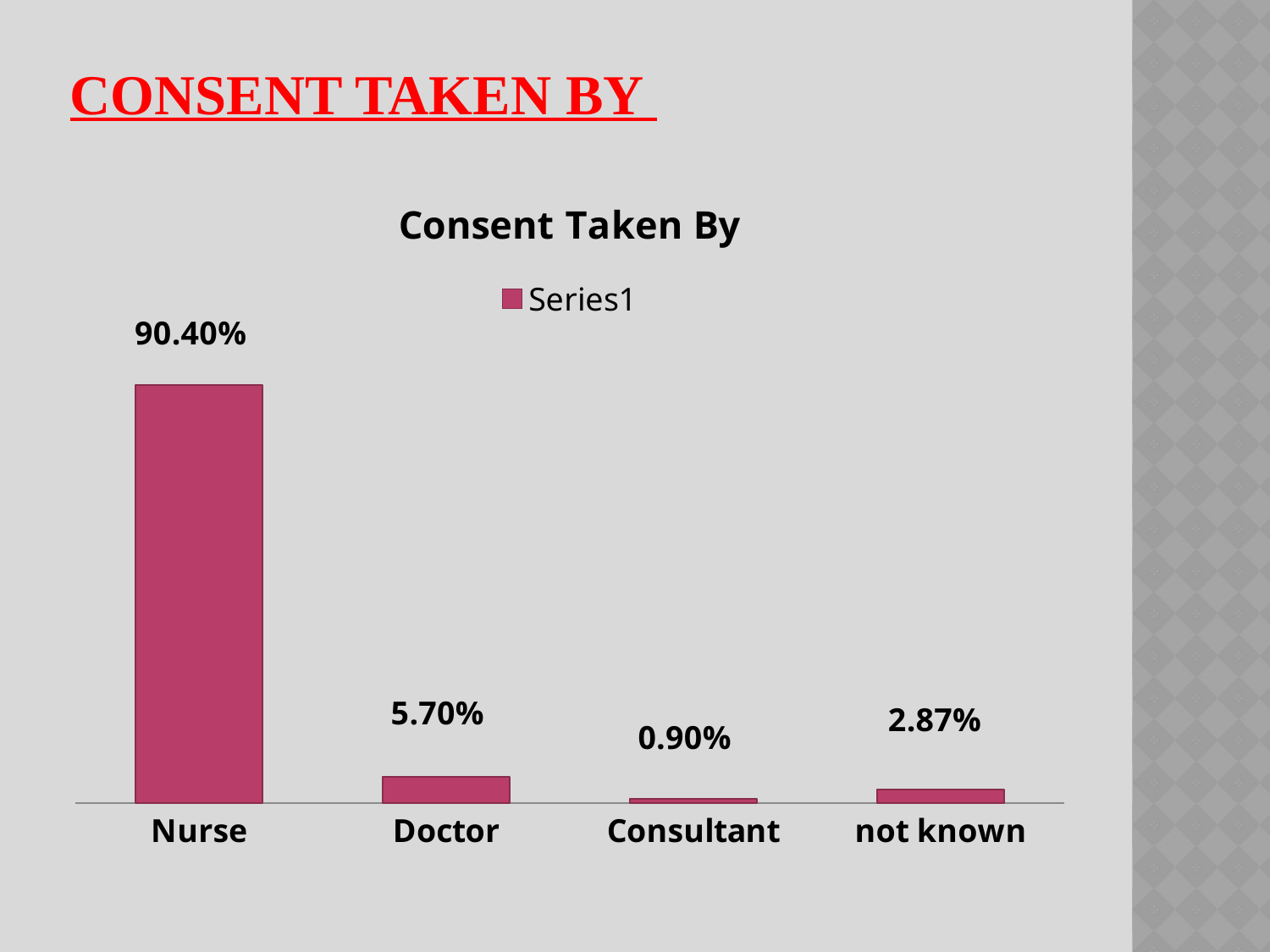
What is the difference between the values for Nurse and Doctor? 84.70% What is the value for not known? 2.87% What is the value for Consultant? 0.90% How many categories are shown on the x axis? 4 How many series does the legend list? 1 What is the difference between the values for not known and Consultant? 1.97% What is the value for Doctor? 5.70% What kind of chart is this? Bar chart What is the value for Nurse? 90.40% Which category has the lowest value? Consultant Which is larger, the value for Doctor or the value for not known? Doctor Which category has the highest value? Nurse